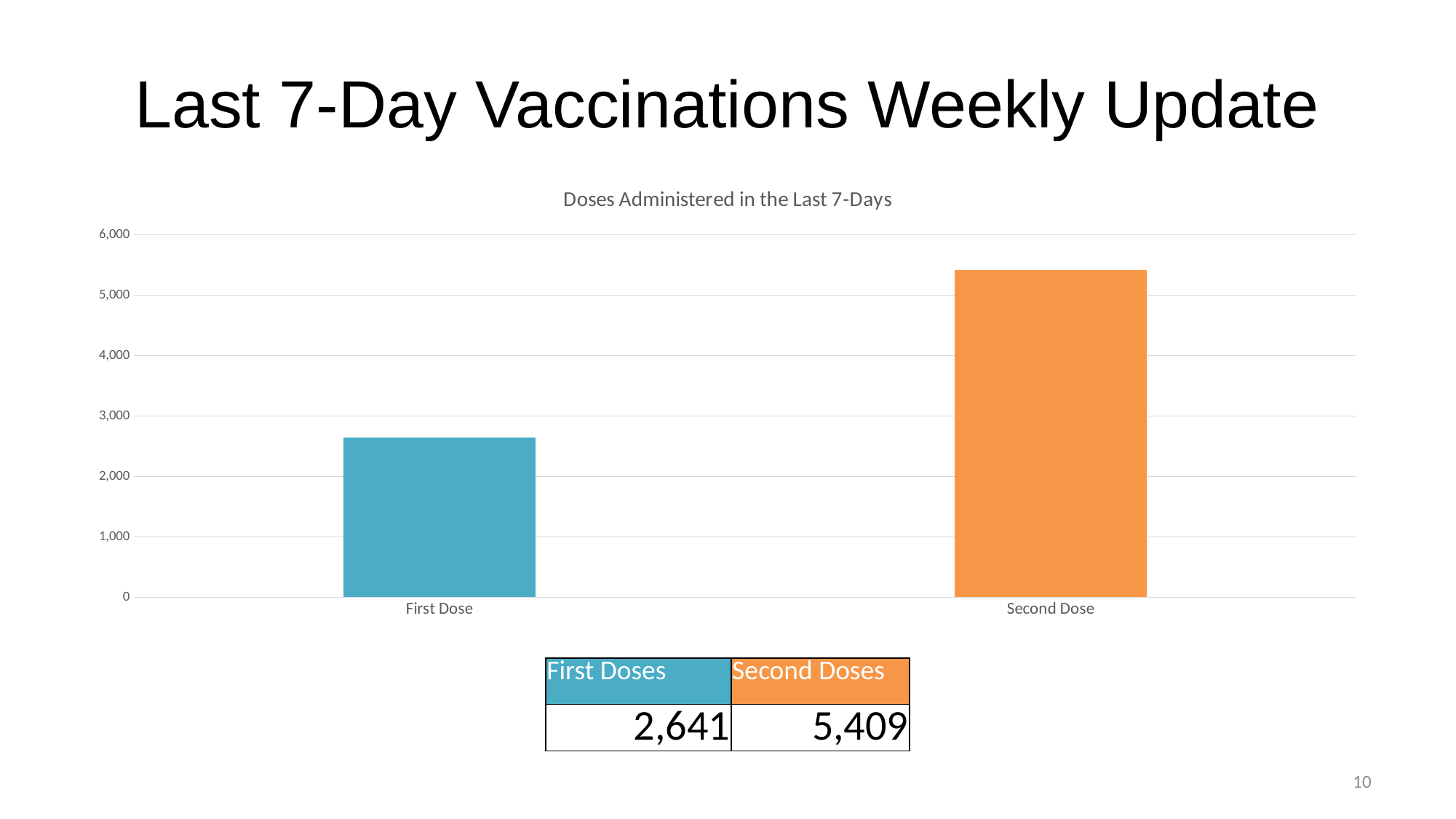
What is the title of the chart? Doses Administered in the Last 7-Days According to the table below the chart, how many first doses were administered? 2,641 Is the value for First Dose greater or less than 2,000? greater What type of chart is shown on the slide? bar chart Which category has the lowest value? First Dose Using the values in the table below the chart, what is the difference between second doses and first doses? 2,768 According to the table below the chart, how many second doses were administered? 5,409 How many categories are plotted in the chart? 2 Which is larger, the value for First Dose or the value for Second Dose? Second Dose Which category has the highest value? Second Dose Is the value for Second Dose greater or less than 5,000? greater Is the value for First Dose greater or less than 3,000? less